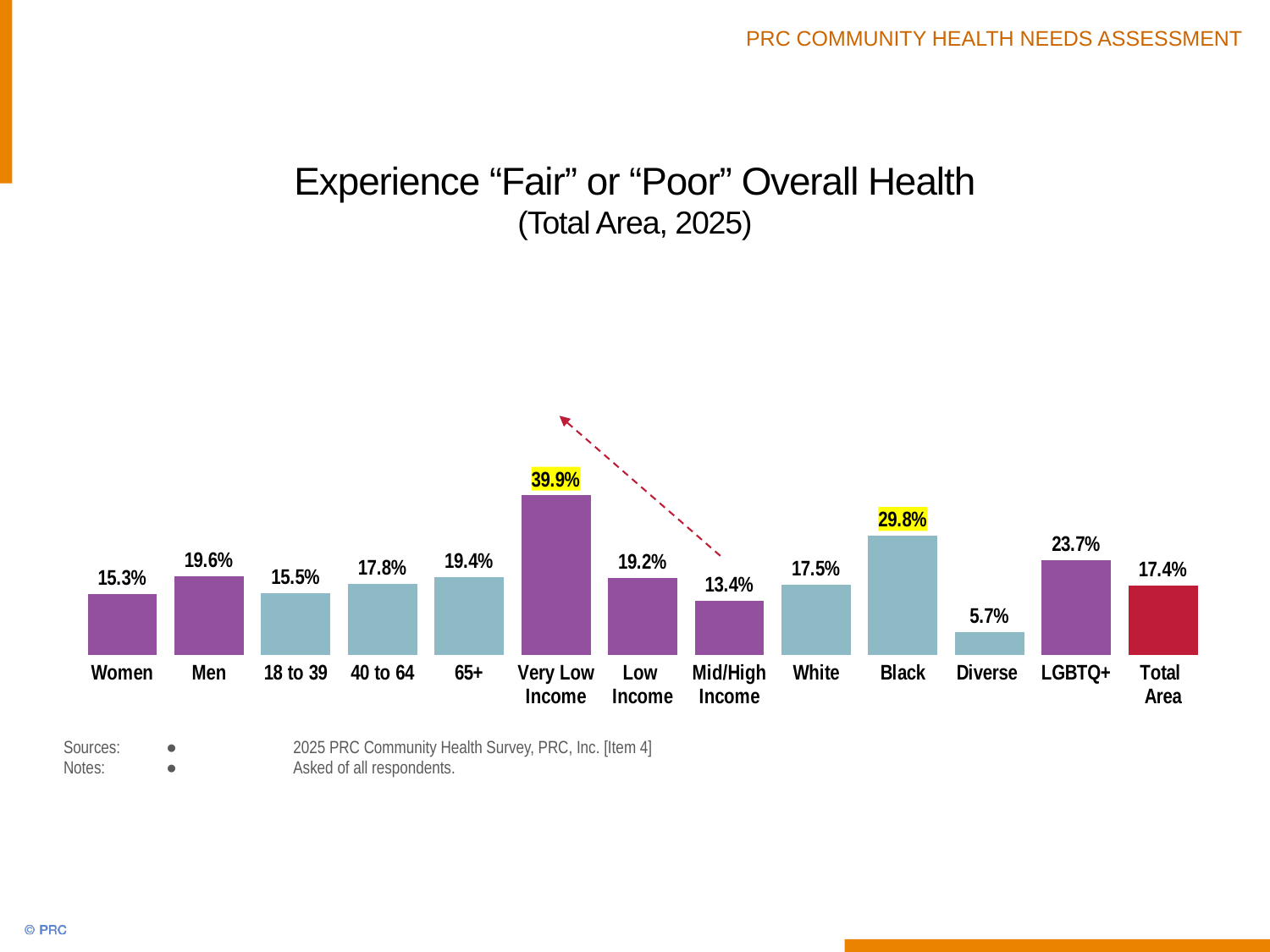
Which category has the highest value? Very Low Income What is the value for Very Low Income? 39.9% Which is larger, the value for 65+ or the value for 18 to 39? 65+ Which is larger, the value for Black or the value for White? Black What is the value for LGBTQ+? 23.7% What is the value for Diverse? 5.7% How many categories are shown in the chart? 13 What is the value for Total Area? 17.4% Which category has the lowest value? Diverse What is the difference between the values for Men and Women? 4.3% What is the difference between the values for Very Low Income and Mid/High Income? 26.5% What kind of chart is shown on the slide? Bar chart